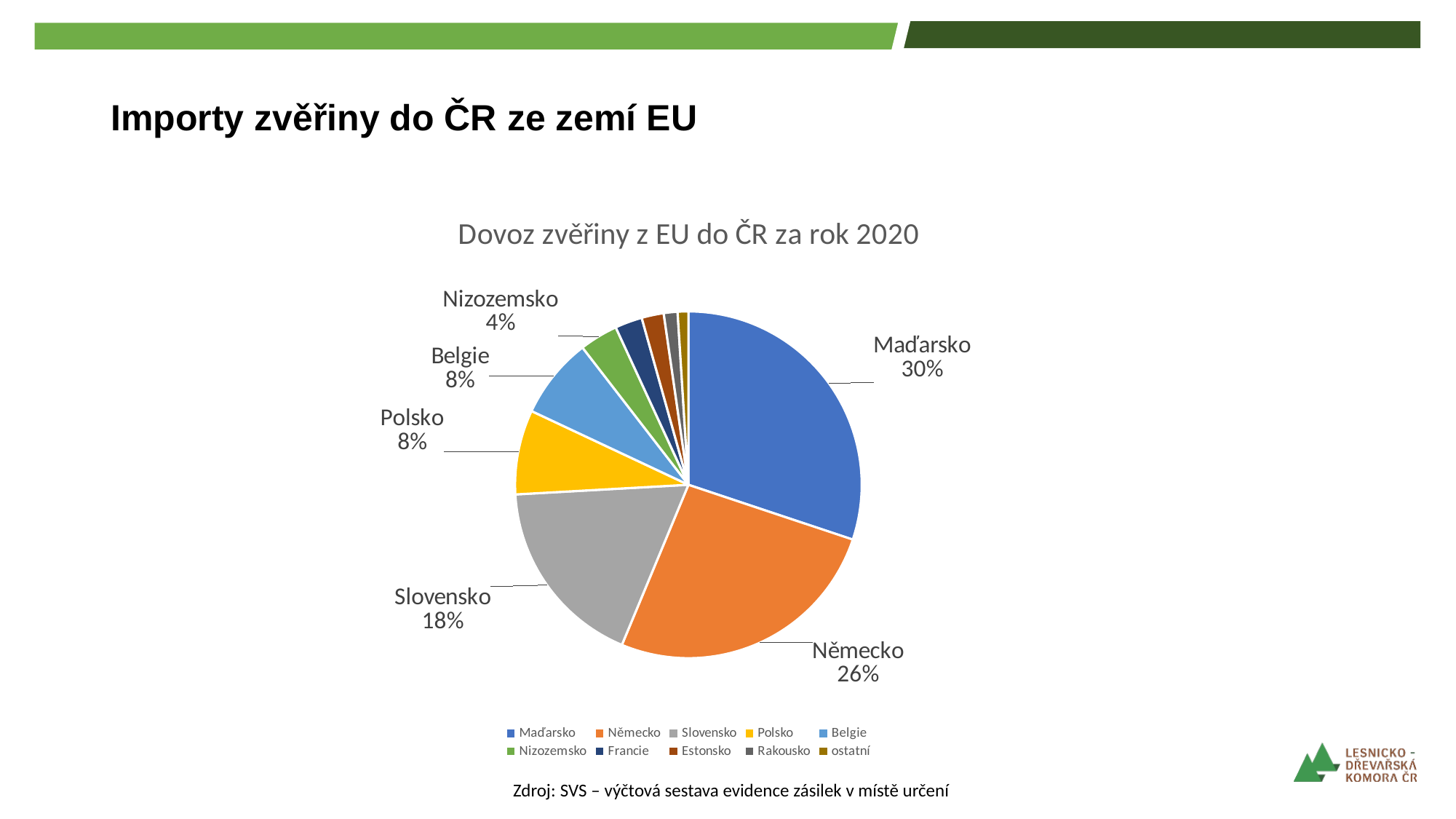
Which country has the largest slice of the pie? Maďarsko What is the value shown for Nizozemsko? 4% What colour is the slice for Polsko? Yellow What kind of chart is shown on the slide? Pie chart How many entries does the legend list? 10 What is the difference between the shares of Slovensko and Belgie? 10% Which is larger, the share of Slovensko or the share of Polsko? Slovensko What is the value shown for Německo? 26% What is the value shown for Slovensko? 18% What share of the pie does Maďarsko hold? 30% What is the title of the chart? Dovoz zvěřiny z EU do ČR za rok 2020 What is the difference between the shares of Maďarsko and Německo? 4%